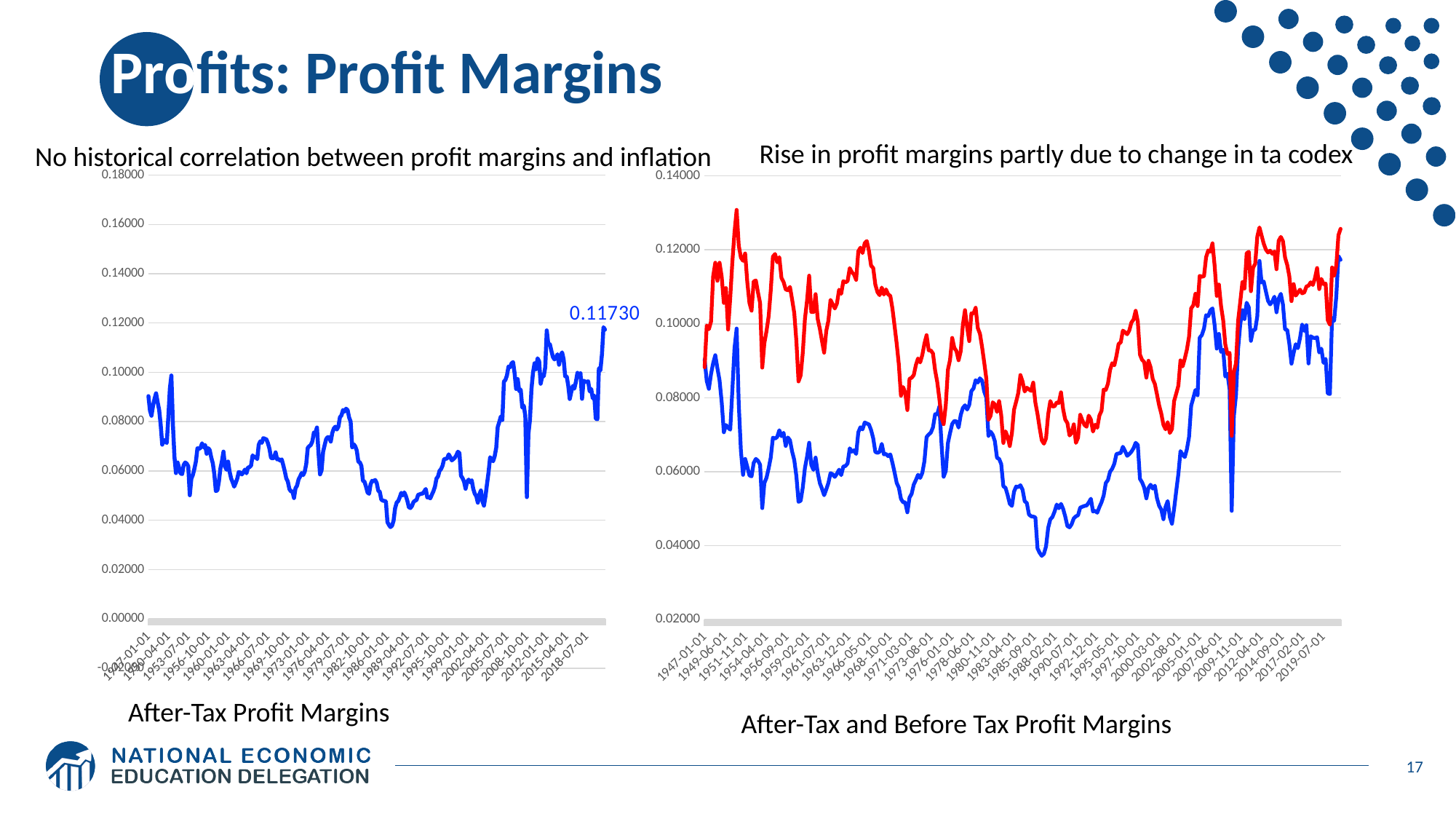
On the After-Tax and Before Tax Profit Margins chart, is the peak of the red line around 1951 greater or less than 0.12000? greater On the After-Tax Profit Margins chart, what is the highest value shown on the vertical axis? 0.18000 On the After-Tax Profit Margins chart, is the lowest point of the line (around 1986) greater or less than 0.06000? less On the After-Tax Profit Margins chart, is the value at 1947-01-01 greater or less than 0.06000? greater What kind of chart is the After-Tax and Before Tax Profit Margins chart on the right? line chart On the After-Tax Profit Margins chart, what is the value shown by the data label at the end of the line? 0.11730 How many lines are plotted on the After-Tax and Before Tax Profit Margins chart on the right? 2 On the After-Tax and Before Tax Profit Margins chart, what is the lowest value shown on the vertical axis? 0.02000 What kind of chart is the After-Tax Profit Margins chart on the left? line chart